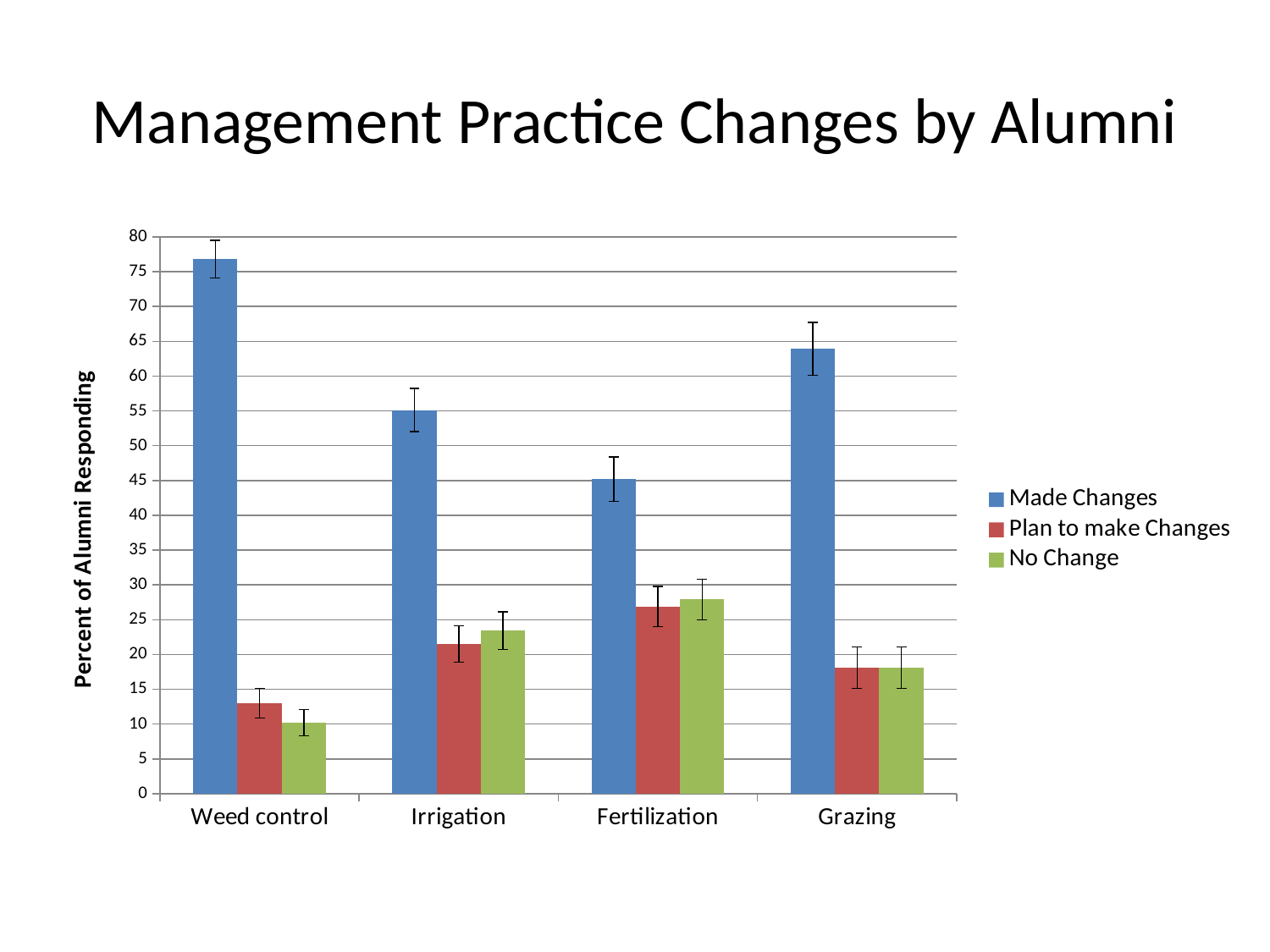
How many management practice categories are shown on the x axis? 4 Is the No Change value for Weed control greater or less than 15? less Which category has the highest value for Plan to make Changes? Fertilization What is the title of the vertical axis? Percent of Alumni Responding Is the Made Changes value for Grazing greater or less than 60? greater Which is larger: the Made Changes value for Weed control or the Made Changes value for Grazing? Weed control Which is larger: the Plan to make Changes value for Fertilization or for Weed control? Fertilization Which category has the lowest value for Made Changes? Fertilization Is the Made Changes value for Weed control greater or less than 70? greater Which category has the highest value for Made Changes? Weed control How many series does the legend list? 3 What kind of chart is shown on the slide? bar chart